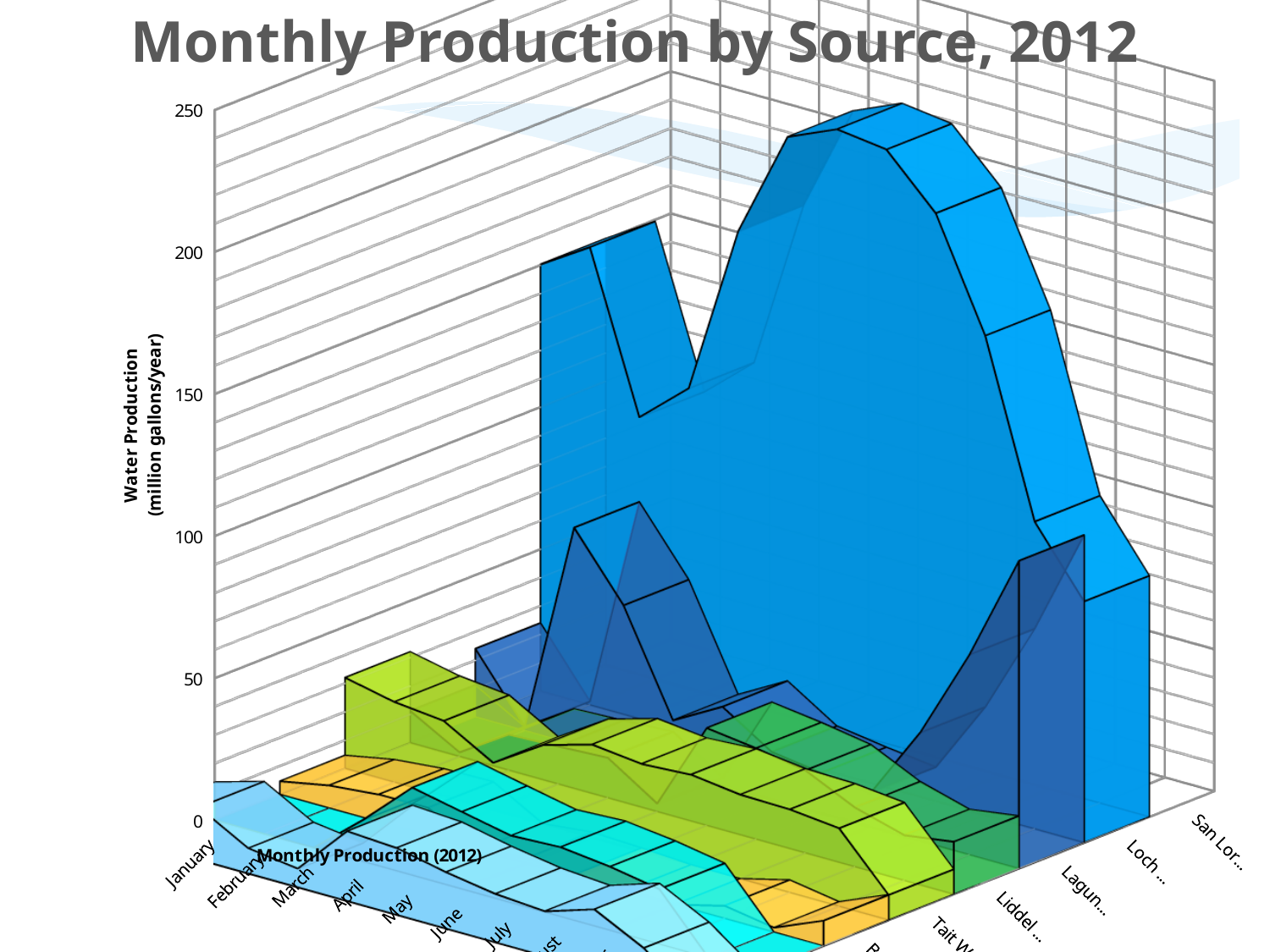
Is the highest value plotted on the chart greater or less than 150? greater What kind of chart is shown on the slide? 3D area chart What is the label on the vertical axis of the chart? Water Production (million gallons/year) What is the title of the chart? Monthly Production by Source, 2012